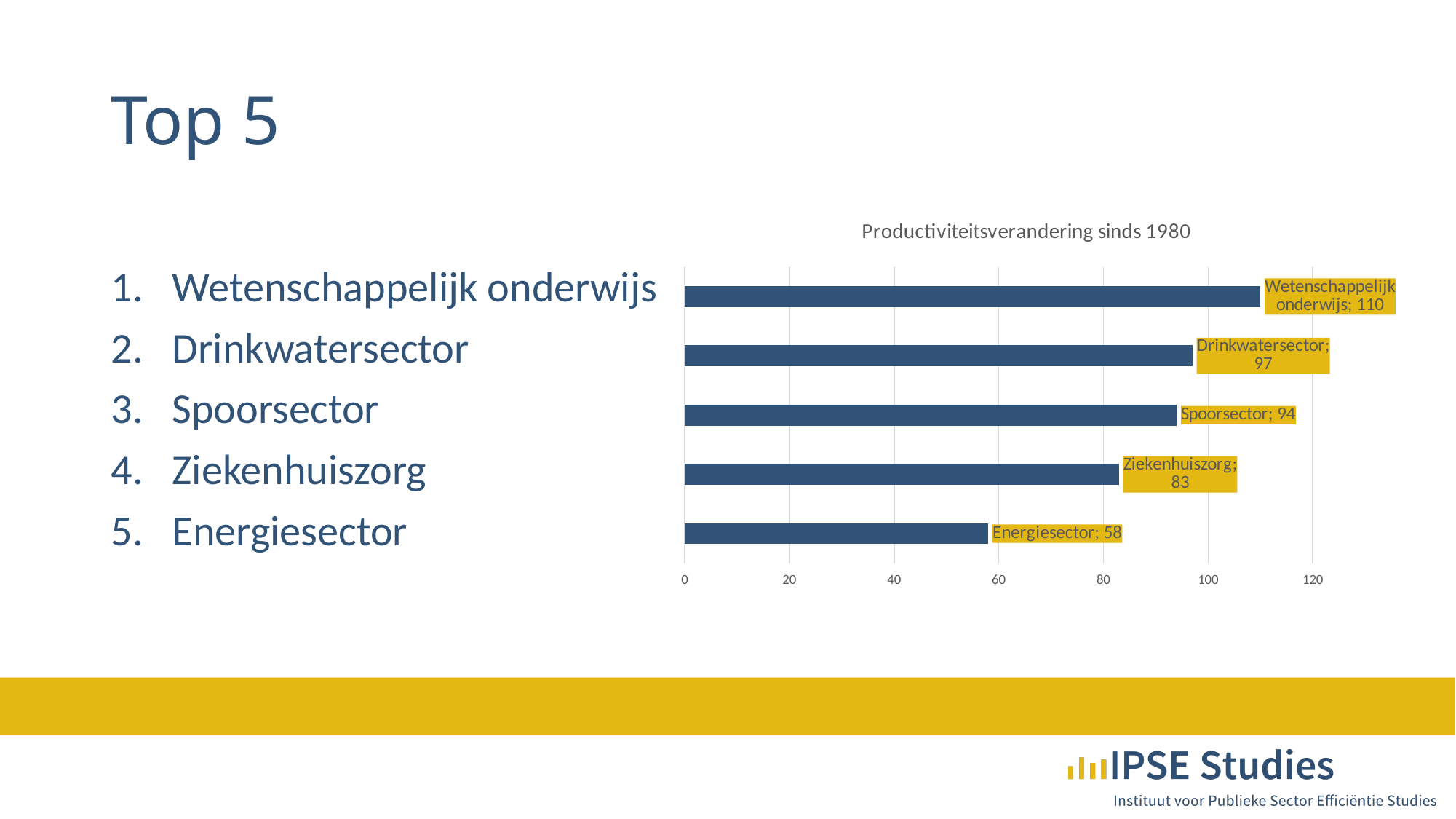
Which category has the lowest value? Energiesector Which is larger, the value for Ziekenhuiszorg or the value for Energiesector? Ziekenhuiszorg What is the value for Ziekenhuiszorg? 83 What is the value for Energiesector? 58 How many categories are shown in the chart? 5 What is the value for Spoorsector? 94 What is the title of the chart? Productiviteitsverandering sinds 1980 What is the value for Drinkwatersector? 97 What is the difference between the values for Wetenschappelijk onderwijs and Energiesector? 52 What is the value for Wetenschappelijk onderwijs? 110 Which category has the highest value? Wetenschappelijk onderwijs What kind of chart is shown on the slide? Bar chart